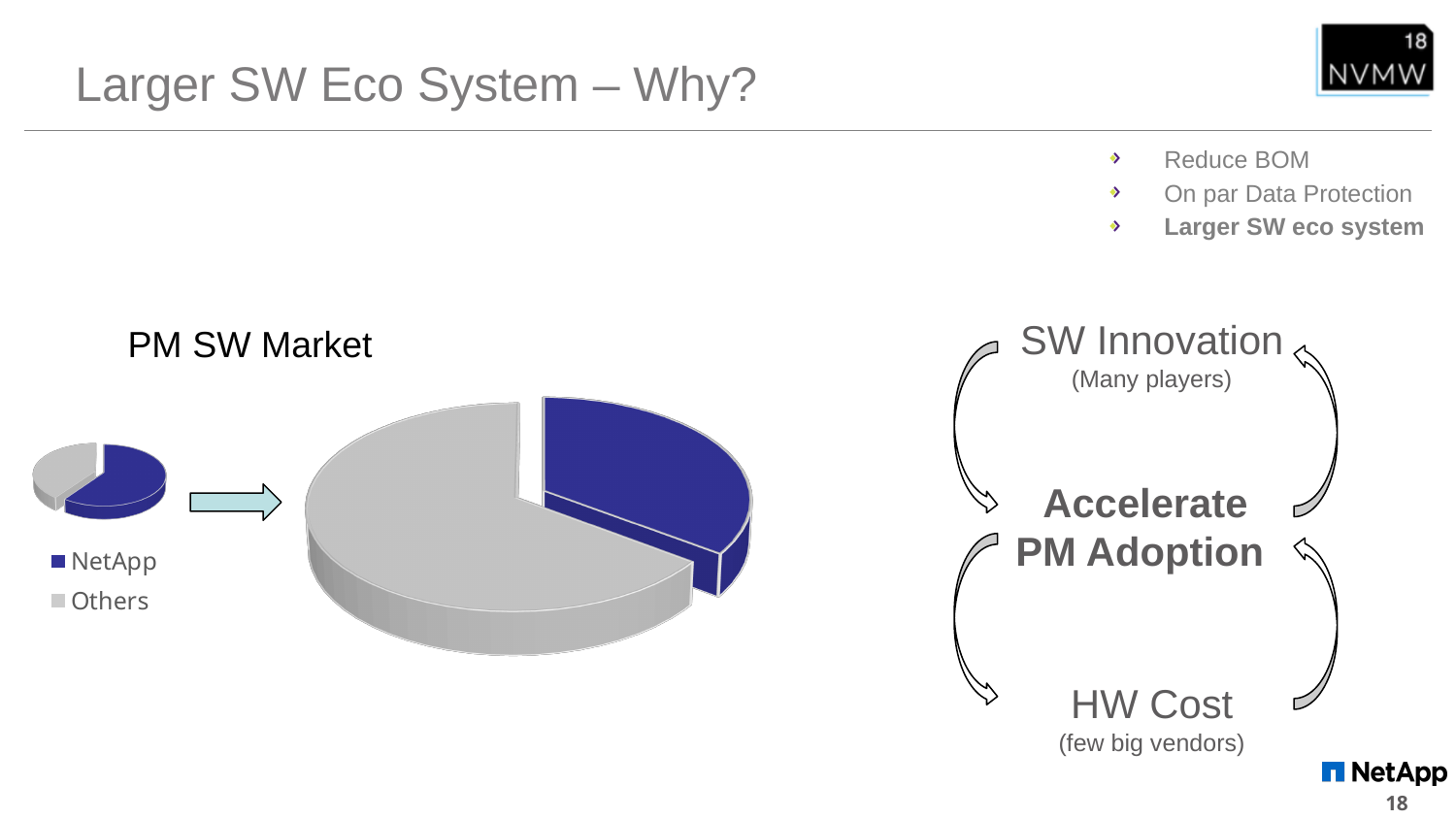
In the PM SW Market pie chart, what colour is the NetApp slice? blue How many entries does the legend of the PM SW Market pie chart list? 2 In the PM SW Market pie chart, which category is shown in grey? Others What is the title of the pie chart on the left side of the slide? PM SW Market What kind of chart is shown under the title "PM SW Market"? pie chart How many slices does the PM SW Market pie chart have? 2